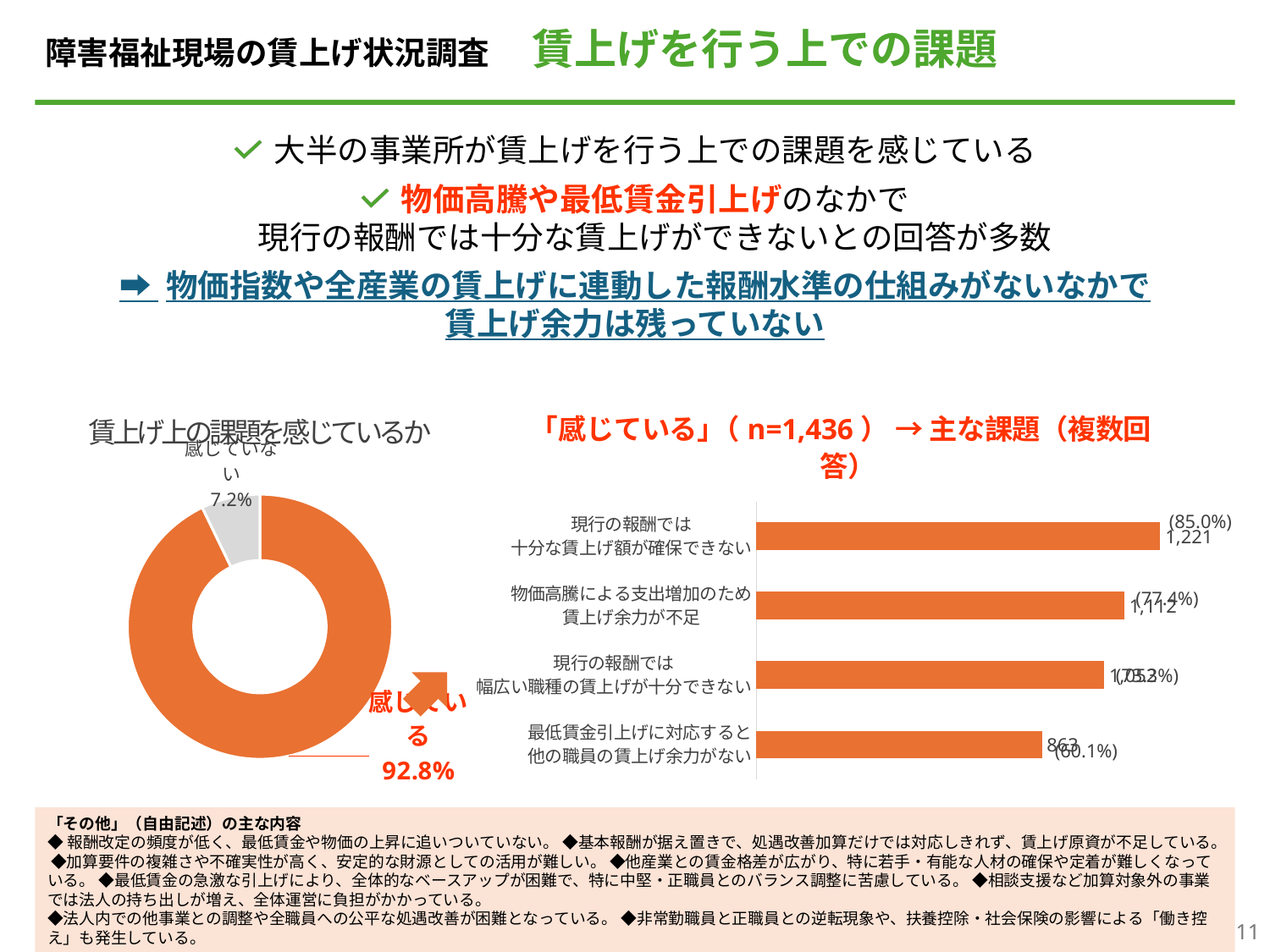
In the bar chart on the right (主な課題), which category has the lowest value? 最低賃金引上げに対応すると他の職員の賃上げ余力がない In the bar chart on the right (主な課題), what percentage is shown for 最低賃金引上げに対応すると他の職員の賃上げ余力がない? 60.1% In the bar chart on the right (主な課題), what percentage is shown for 現行の報酬では十分な賃上げ額が確保できない? 85.0% In the bar chart on the right (主な課題), how many categories are plotted? 4 In the bar chart on the right (主な課題), how many respondents selected 現行の報酬では十分な賃上げ額が確保できない? 1,221 In the bar chart on the right (主な課題), which category has the highest value? 現行の報酬では十分な賃上げ額が確保できない In the bar chart on the right (主な課題), how many respondents selected 最低賃金引上げに対応すると他の職員の賃上げ余力がない? 863 In the bar chart on the right (主な課題), what is the difference in respondents between 現行の報酬では十分な賃上げ額が確保できない and 最低賃金引上げに対応すると他の職員の賃上げ余力がない? 358 In the donut chart titled 賃上げ上の課題を感じているか, what share of respondents answered 感じていない? 7.2% In the donut chart titled 賃上げ上の課題を感じているか, what share of respondents answered 感じている? 92.8% What kind of chart is the chart on the left titled 賃上げ上の課題を感じているか? Pie (donut) chart In the bar chart on the right (主な課題), which is larger: 物価高騰による支出増加のため賃上げ余力が不足 or 最低賃金引上げに対応すると他の職員の賃上げ余力がない? 物価高騰による支出増加のため賃上げ余力が不足